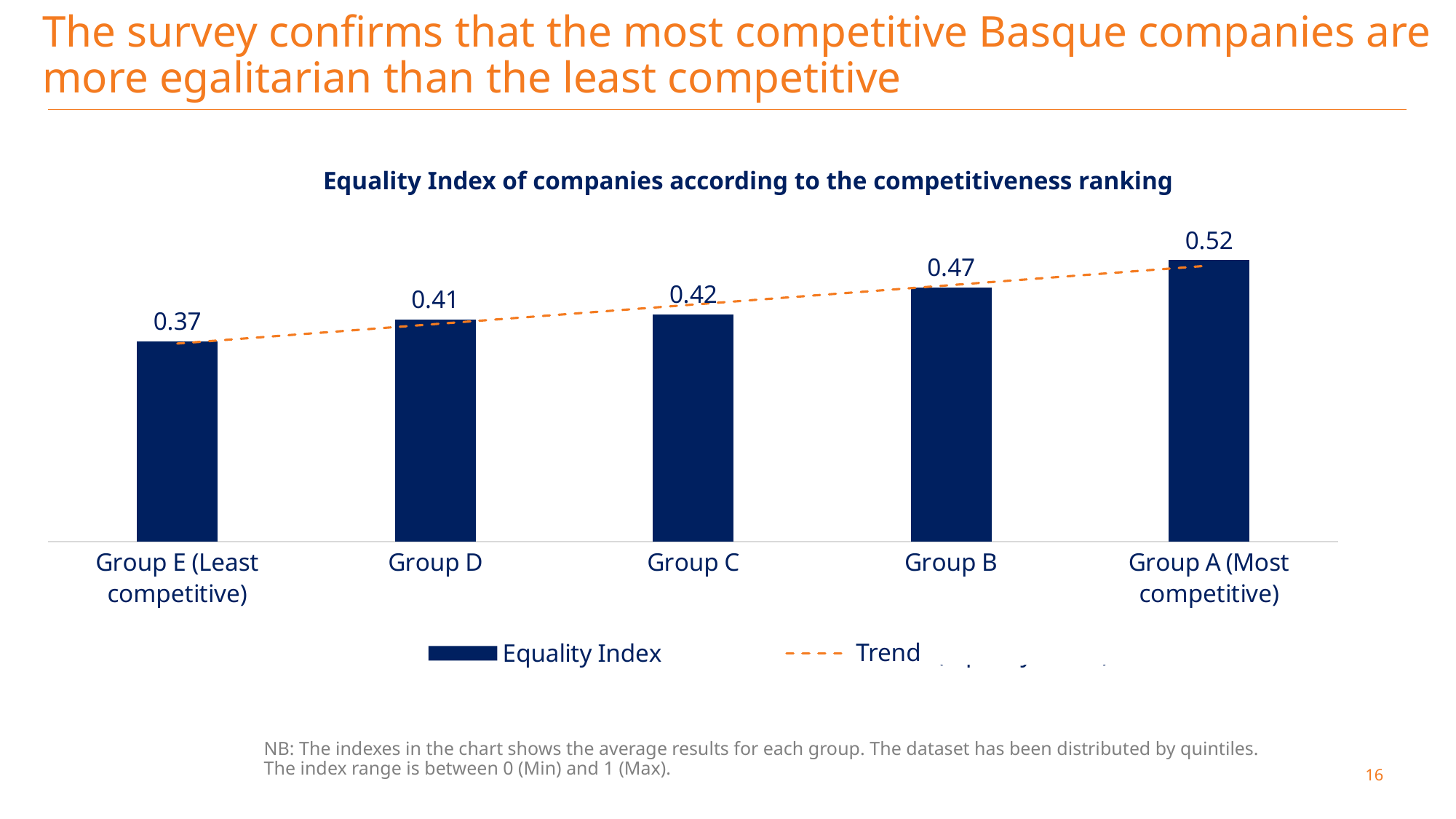
What kind of chart is used to show the Equality Index? Bar chart Which group has the lowest Equality Index? Group E (Least competitive) What is the difference between the Equality Index of Group A (Most competitive) and Group E (Least competitive)? 0.15 What is the difference between the Equality Index of Group B and Group D? 0.06 How many entries does the legend list? 2 What is the Equality Index for Group E (Least competitive)? 0.37 Which group has the highest Equality Index? Group A (Most competitive) What is the Equality Index for Group B? 0.47 How many groups are shown on the chart? 5 Which has a higher Equality Index, Group D or Group B? Group B What is the Equality Index for Group C? 0.42 Do the Equality Index values rise or fall from Group E to Group A along the x axis? Rise